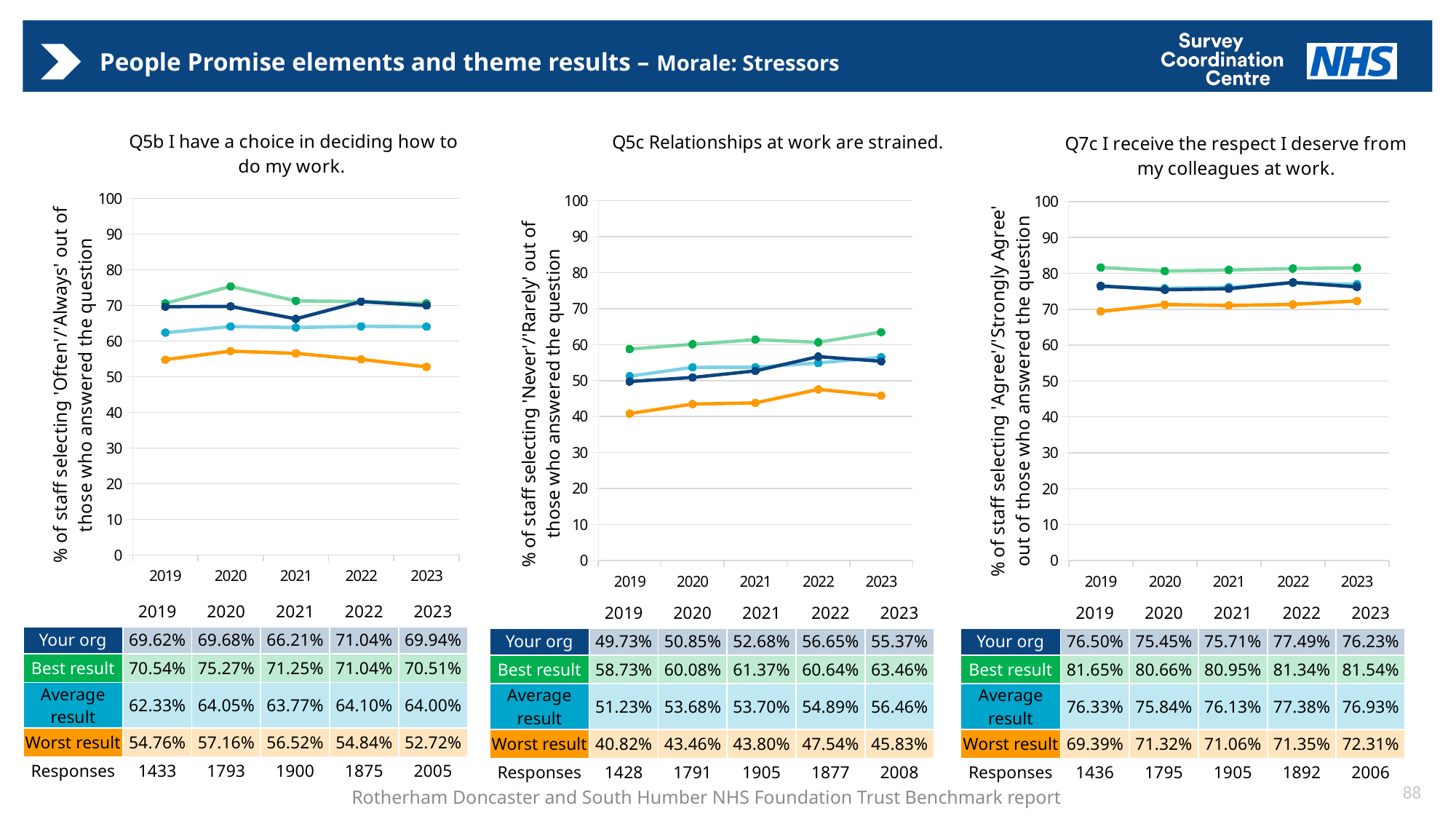
In the Q7c chart, what is the difference between the 'Best result' and 'Worst result' values for 2019? 12.26% In the Q5b chart, in which year was the 'Best result' value highest? 2020 How many years are plotted on the x axis of the Q5c chart? 5 What kind of chart is used for Q7c 'I receive the respect I deserve from my colleagues at work'? Line chart In the Q7c 'I receive the respect I deserve from my colleagues at work' chart, what is the 'Best result' value for 2023? 81.54% How many charts are shown on the slide? 3 In the Q5b chart, is the 'Worst result' value for 2023 greater or less than 60? less In the Q5c chart, in which year was the 'Your org' value lowest? 2019 In the Q5c chart, which is larger in 2022: the 'Your org' value or the 'Average result' value? Your org In the Q5b 'I have a choice in deciding how to do my work' chart, what is the 'Your org' value for 2022? 71.04% In the Q5c 'Relationships at work are strained' chart, what is the 'Worst result' value for 2019? 40.82% In the Q5c chart, does the 'Best result' line generally rise or fall from 2019 to 2023? Rise